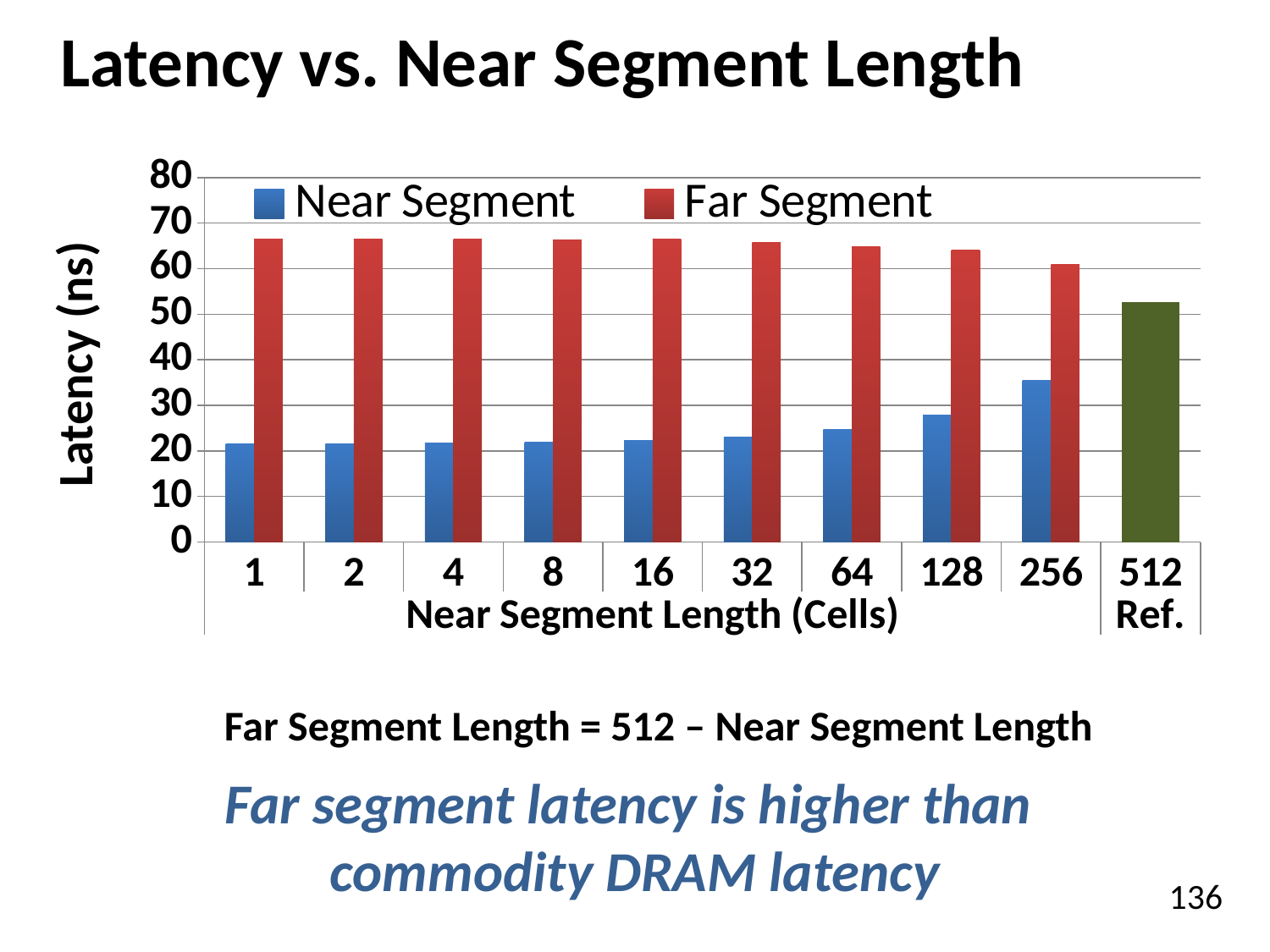
At near segment length 256, which is larger: the Far Segment latency or the 512 Ref. latency? Far Segment Is the Near Segment value at near segment length 1 greater or less than 30? less What kind of chart is shown on the slide? bar chart How many categories are shown along the x axis? 10 At which near segment length is the Far Segment latency lowest? 256 At which near segment length is the Near Segment latency highest? 256 Is the Near Segment value at near segment length 256 greater or less than 30? greater How many series does the legend list? 2 Does the Near Segment latency rise or fall as near segment length increases from 1 to 256? rise Is the value of the 512 Ref. bar greater or less than 50? greater